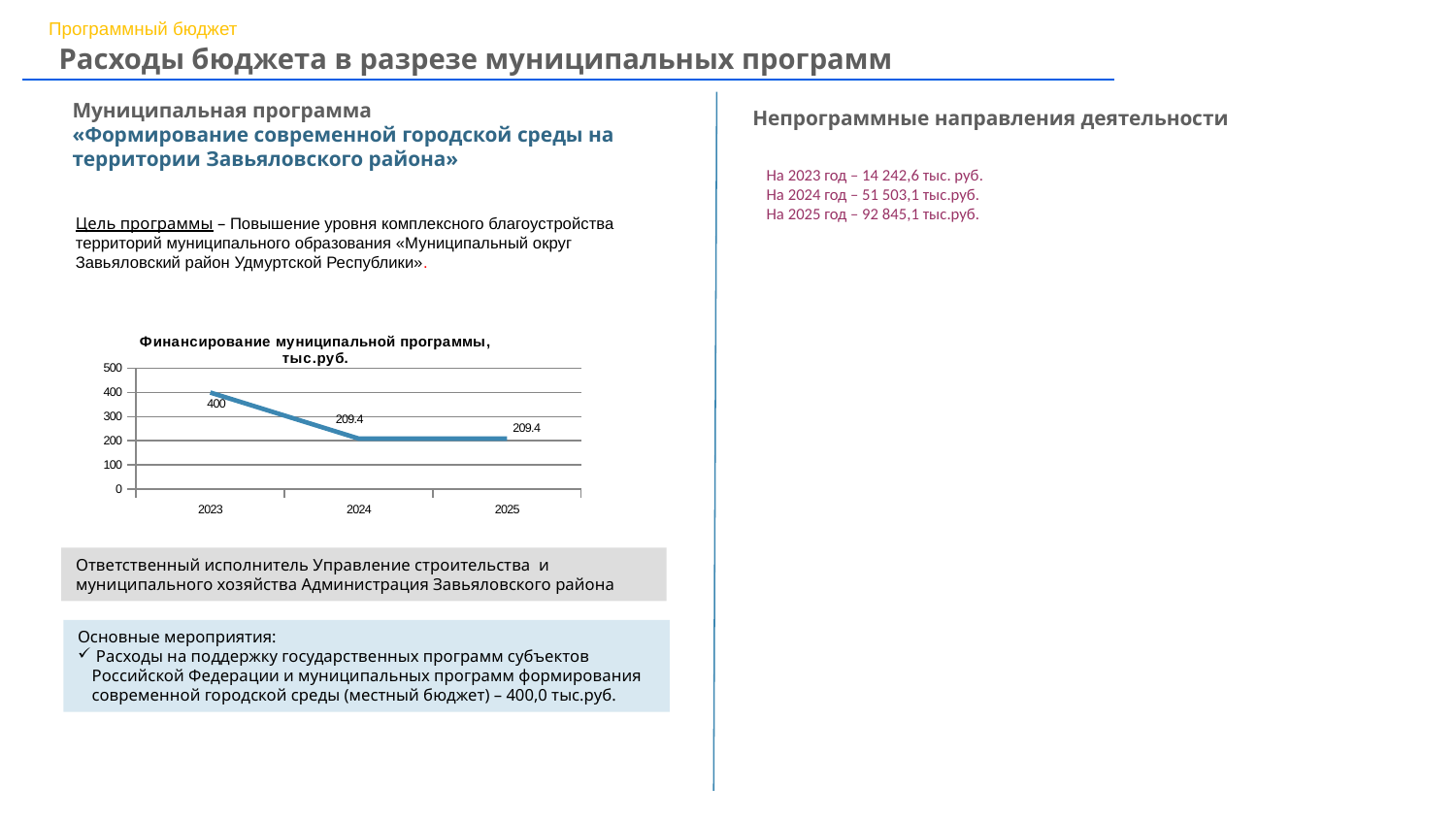
What is the value for 2025 in the chart? 209.4 Which year has the highest value in the chart? 2023 What is the maximum value shown on the y axis of the chart? 500 What is the difference between the values for 2023 and 2024? 190.6 What kind of chart is shown on the slide? line chart What is the value for 2024 in the chart? 209.4 What is the value for 2023 in the chart 'Финансирование муниципальной программы, тыс.руб.'? 400 Is the value for 2024 greater or less than 300? less How many years are plotted on the x axis of the chart? 3 What is the title of the chart? Финансирование муниципальной программы, тыс.руб. Do the values rise or fall from 2023 to 2024? fall Which is larger, the value for 2023 or the value for 2025? 2023